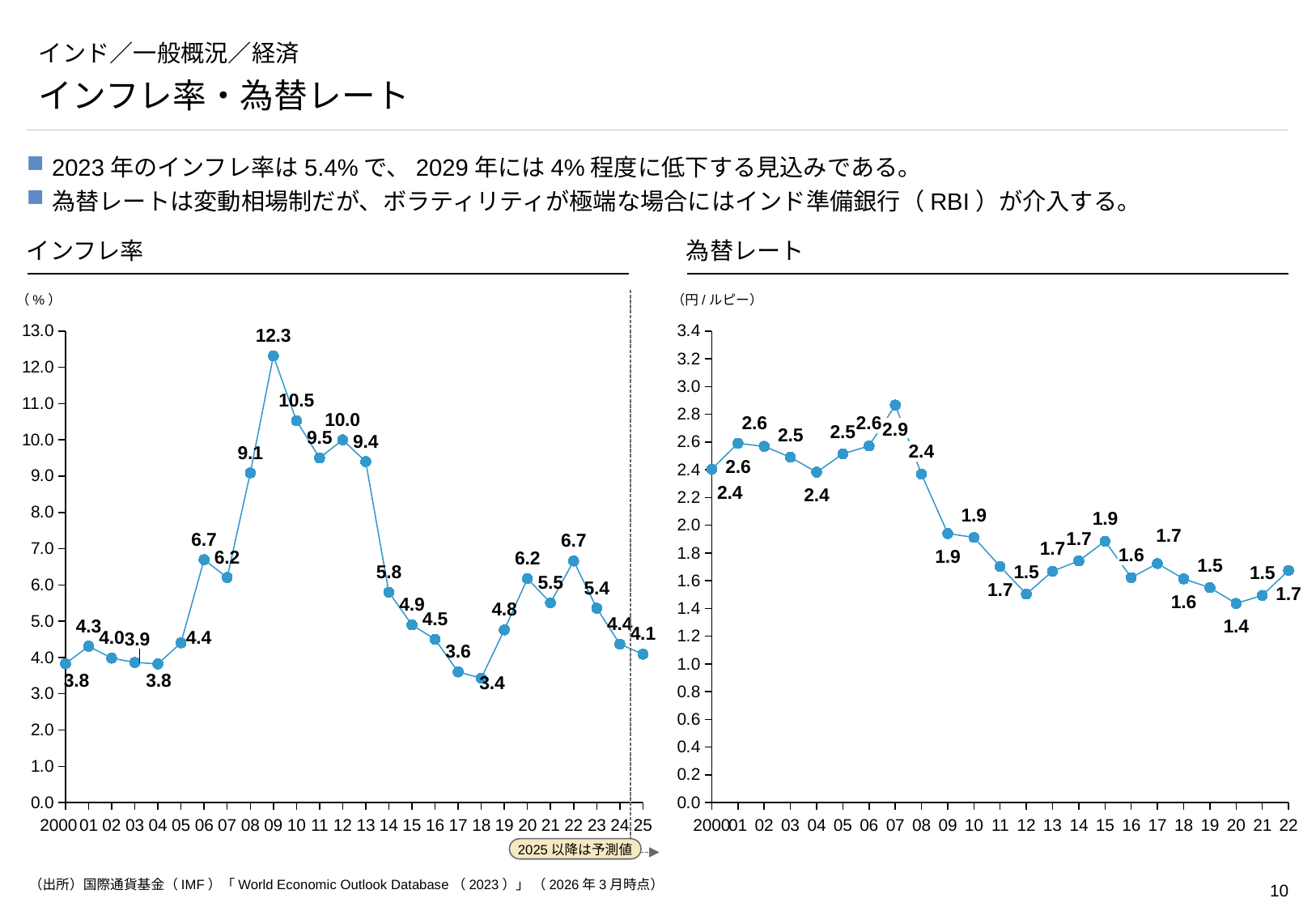
In the 為替レート chart on the right, what is the difference between the 2007 and 2020 values? 1.4 In the 為替レート chart on the right, what is the value for 2020? 1.4 In the インフレ率 chart on the left, what is the inflation rate for 2023? 5.4 In the インフレ率 chart on the left, how many years are plotted? 26 In the 為替レート chart on the right, which year has the highest value? 2007 In the インフレ率 chart on the left, what is the difference between the 2009 and 2010 values? 1.8 In the インフレ率 chart on the left, what is the inflation rate for 2009? 12.3 In the インフレ率 chart on the left, which year has the lowest inflation rate? 2018 In the インフレ率 chart on the left, which year has the highest inflation rate? 2009 What type of chart is the 為替レート chart on the right? line chart In the 為替レート chart on the right, do the values rise or fall from 2008 to 2012? fall In the インフレ率 chart on the left, which is larger, the value for 2014 or the value for 2020? 2020